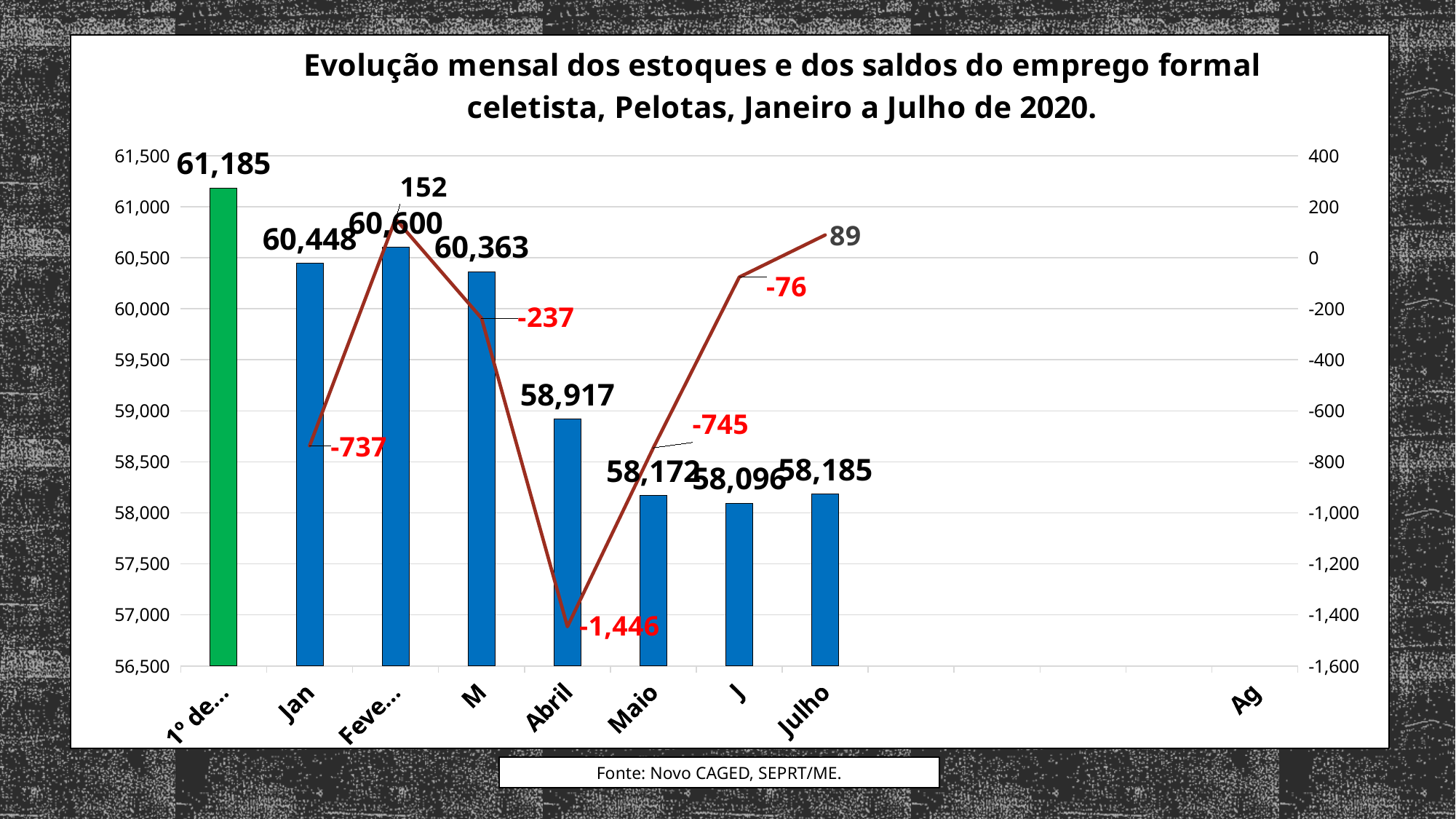
What is the value of the tallest bar? 61,185 What is the difference between the bar values for Jan and Abril? 1,531 What is the bar value for Julho? 58,185 What is the line value (saldo) for Julho? 89 What is the line value (saldo) for Maio? -745 What is the bar value for Abril? 58,917 What is the bar value for Jan? 60,448 Which bar is taller, Jan or Abril? Jan Which month has the lowest value on the line (saldo)? Abril What is the bar value for Maio? 58,172 How many bars are plotted in the chart? 8 What is the line value (saldo) for Abril? -1,446